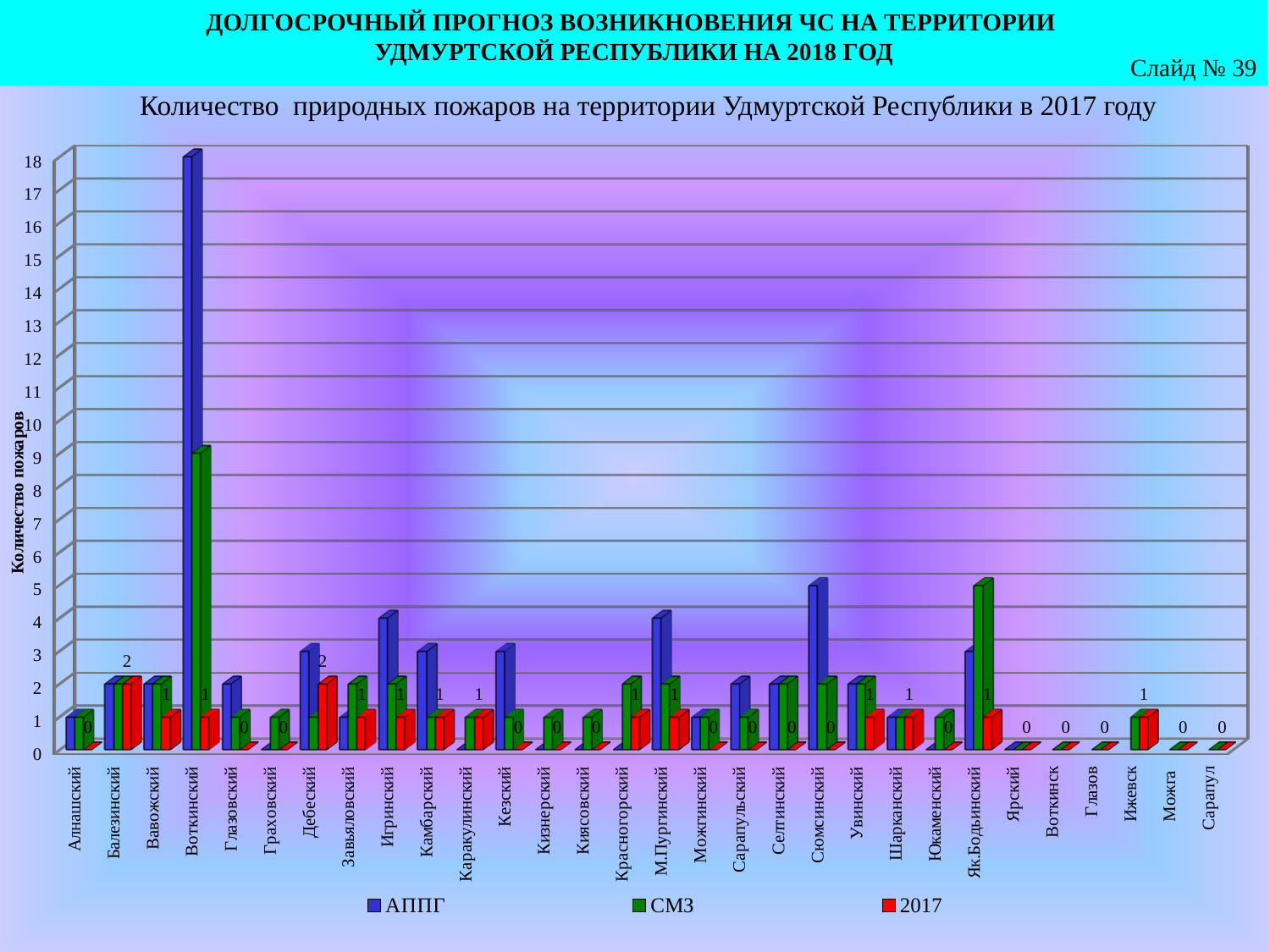
What is the difference between the 2017 values for Балезинский and Вавожский? 1 What is the 2017 value for Балезинский? 2 Is the АППГ value for Воткинский greater or less than 15? greater Is the СМЗ value for Воткинский greater or less than 5? greater What kind of chart is shown on the slide? bar chart Which category has the highest АППГ value? Воткинский Which has the larger 2017 value, Балезинский or Вавожский? Балезинский What is the 2017 value for Сарапул? 0 How many series does the legend list? 3 What is the 2017 value for Ижевск? 1 What is the 2017 value for Дебеский? 2 How many categories are shown on the x axis? 30